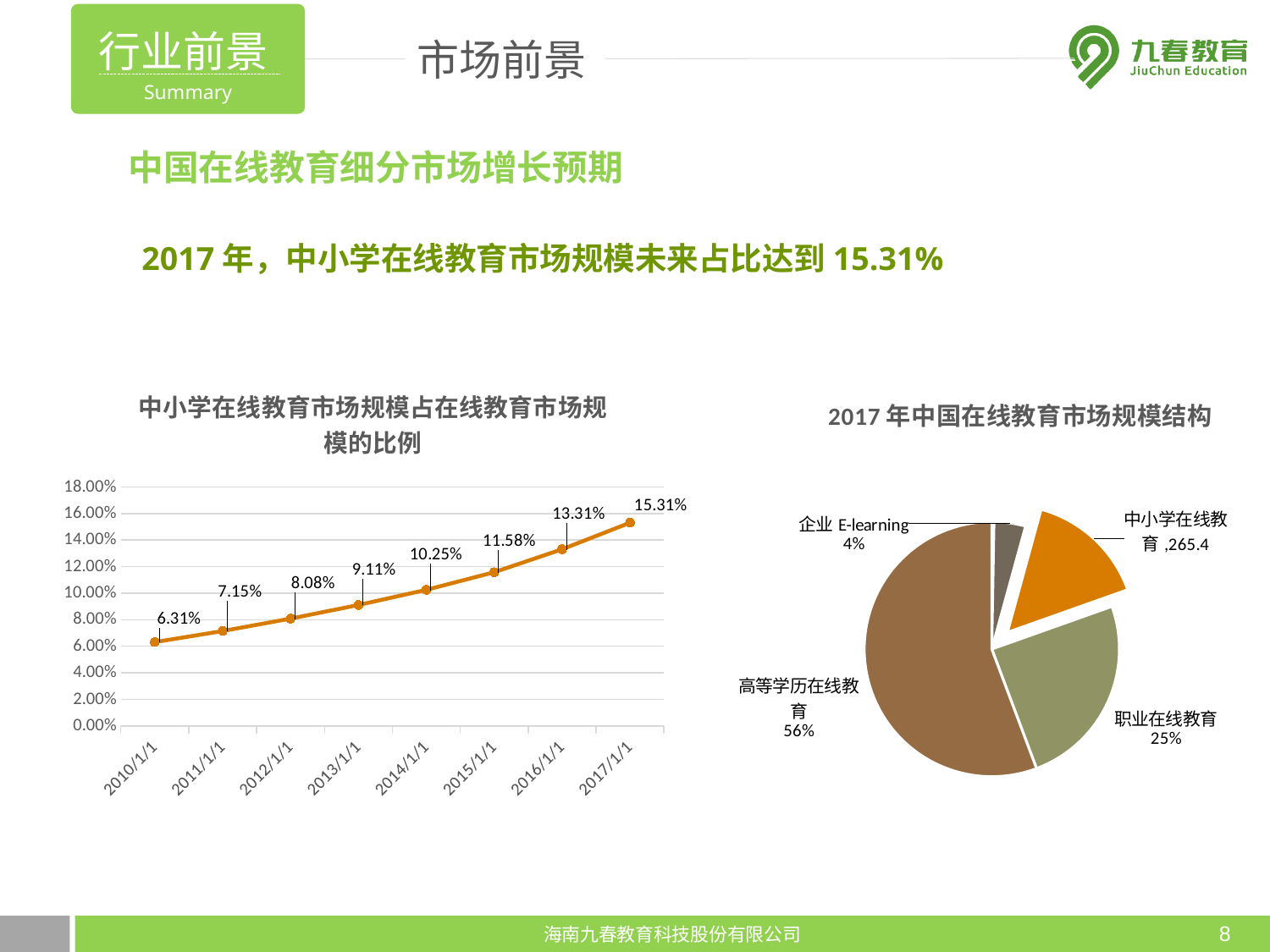
In the left chart (中小学在线教育市场规模占在线教育市场规模的比例), what is the value for 2010/1/1? 6.31% In the left chart (中小学在线教育市场规模占在线教育市场规模的比例), do the values rise or fall from 2010/1/1 to 2017/1/1? rise In the left chart (中小学在线教育市场规模占在线教育市场规模的比例), how many data points are plotted? 8 In the right chart (2017年中国在线教育市场规模结构), what share does 企业E-learning have? 4% What kind of chart is the right chart (2017年中国在线教育市场规模结构)? pie chart In the right chart (2017年中国在线教育市场规模结构), what share does 高等学历在线教育 have? 56% What kind of chart is the left chart (中小学在线教育市场规模占在线教育市场规模的比例)? line chart In the left chart (中小学在线教育市场规模占在线教育市场规模的比例), which date has the highest value? 2017/1/1 In the left chart (中小学在线教育市场规模占在线教育市场规模的比例), what is the value for 2017/1/1? 15.31% In the left chart (中小学在线教育市场规模占在线教育市场规模的比例), which date has the lowest value? 2010/1/1 In the left chart (中小学在线教育市场规模占在线教育市场规模的比例), what is the difference between the values for 2017/1/1 and 2016/1/1? 2.00% In the left chart (中小学在线教育市场规模占在线教育市场规模的比例), what is the value for 2014/1/1? 10.25%